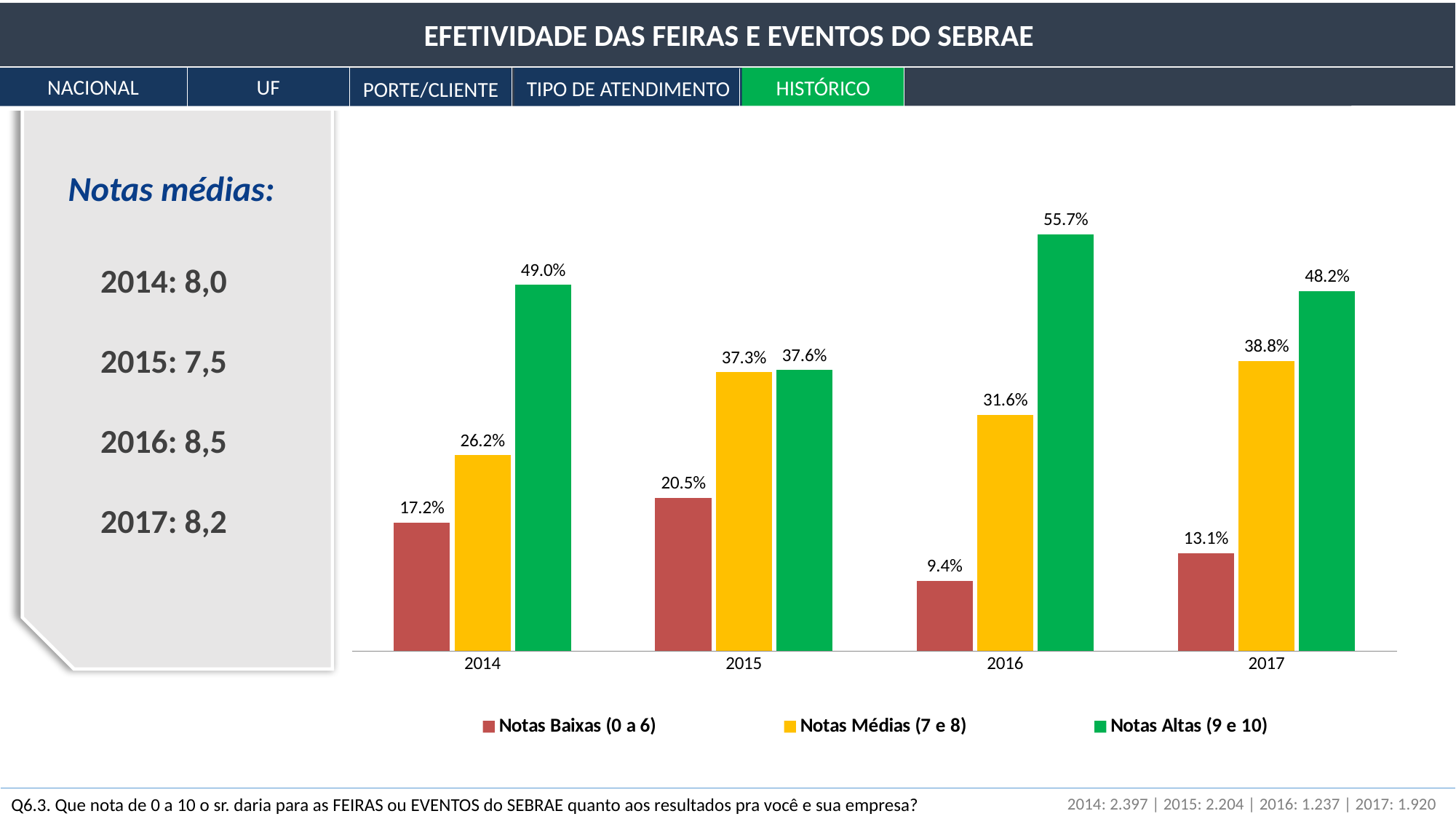
Does the Notas Médias (7 e 8) value rise or fall from 2014 to 2015? rise In which year is the Notas Baixas (0 a 6) value lowest? 2016 Which is larger in 2015: Notas Médias (7 e 8) or Notas Baixas (0 a 6)? Notas Médias (7 e 8) What is the value for Notas Médias (7 e 8) in 2017? 38.8% What is the value for Notas Altas (9 e 10) in 2016? 55.7% In which year is the Notas Altas (9 e 10) value highest? 2016 How many years are shown on the x axis? 4 What is the value for Notas Baixas (0 a 6) in 2014? 17.2% Which colour represents Notas Altas (9 e 10) in the legend? green What is the difference between the Notas Altas (9 e 10) values for 2016 and 2017? 7.5% What kind of chart is shown? bar chart How many series does the legend list? 3